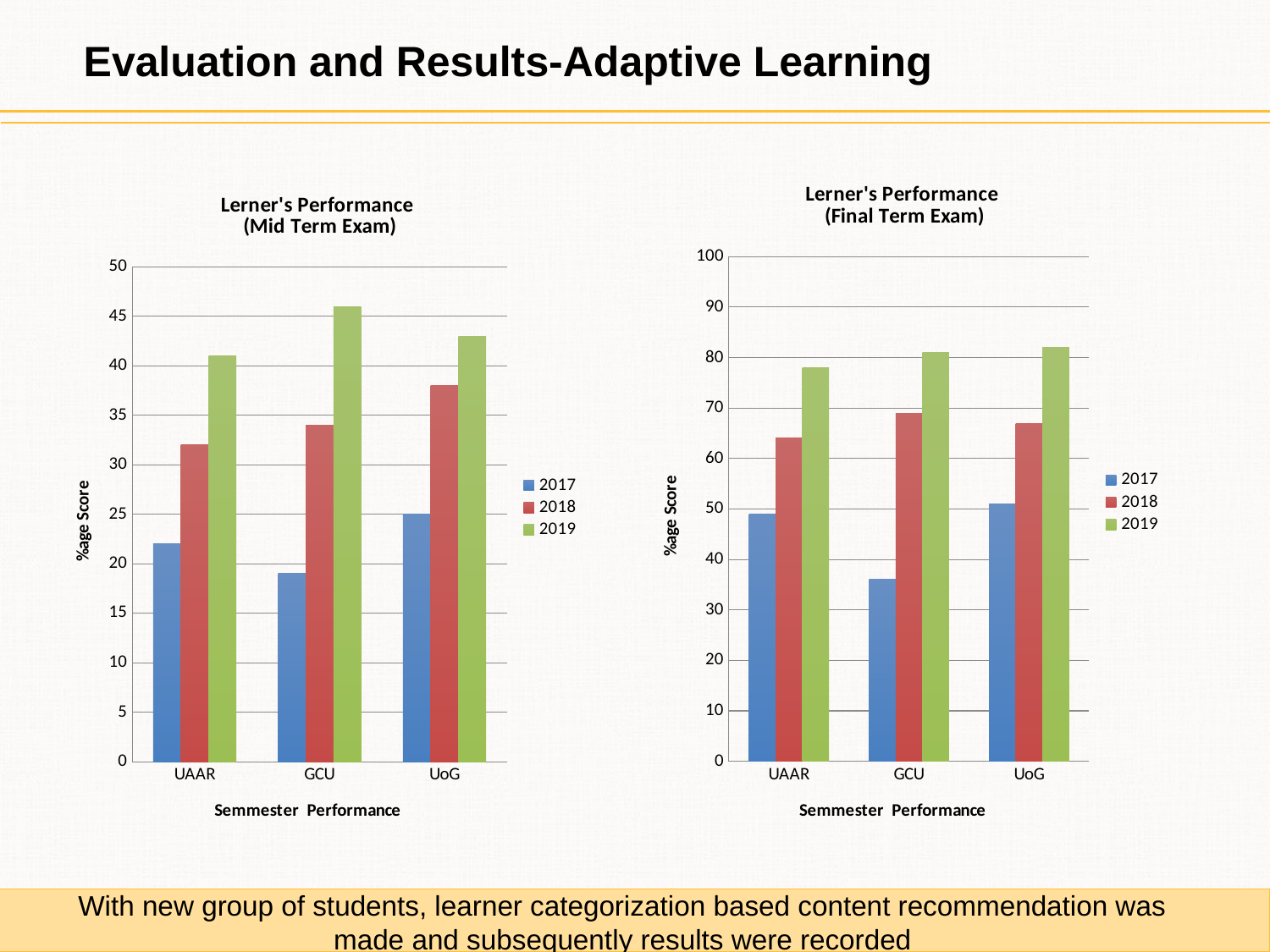
What type of chart is the "Lerner's Performance (Mid Term Exam)" chart? bar chart In the "Lerner's Performance (Final Term Exam)" chart, which category has the lowest 2017 bar? GCU What is the y-axis label of the "Lerner's Performance (Final Term Exam)" chart? %age Score In the "Lerner's Performance (Final Term Exam)" chart, is the 2017 value for GCU greater or less than 40? less In the "Lerner's Performance (Mid Term Exam)" chart, which category has the highest 2019 bar? GCU In the "Lerner's Performance (Mid Term Exam)" chart, is the 2017 value for UAAR greater or less than 25? less How many series does the legend of the "Lerner's Performance (Final Term Exam)" chart list? 3 How many categories are shown on the x axis of the "Lerner's Performance (Mid Term Exam)" chart? 3 In the "Lerner's Performance (Mid Term Exam)" chart, is the 2019 value for GCU greater or less than 40? greater In the "Lerner's Performance (Mid Term Exam)" chart, which is larger: the 2018 value for UoG or the 2018 value for UAAR? UoG In the "Lerner's Performance (Mid Term Exam)" chart, which category has the lowest 2017 bar? GCU